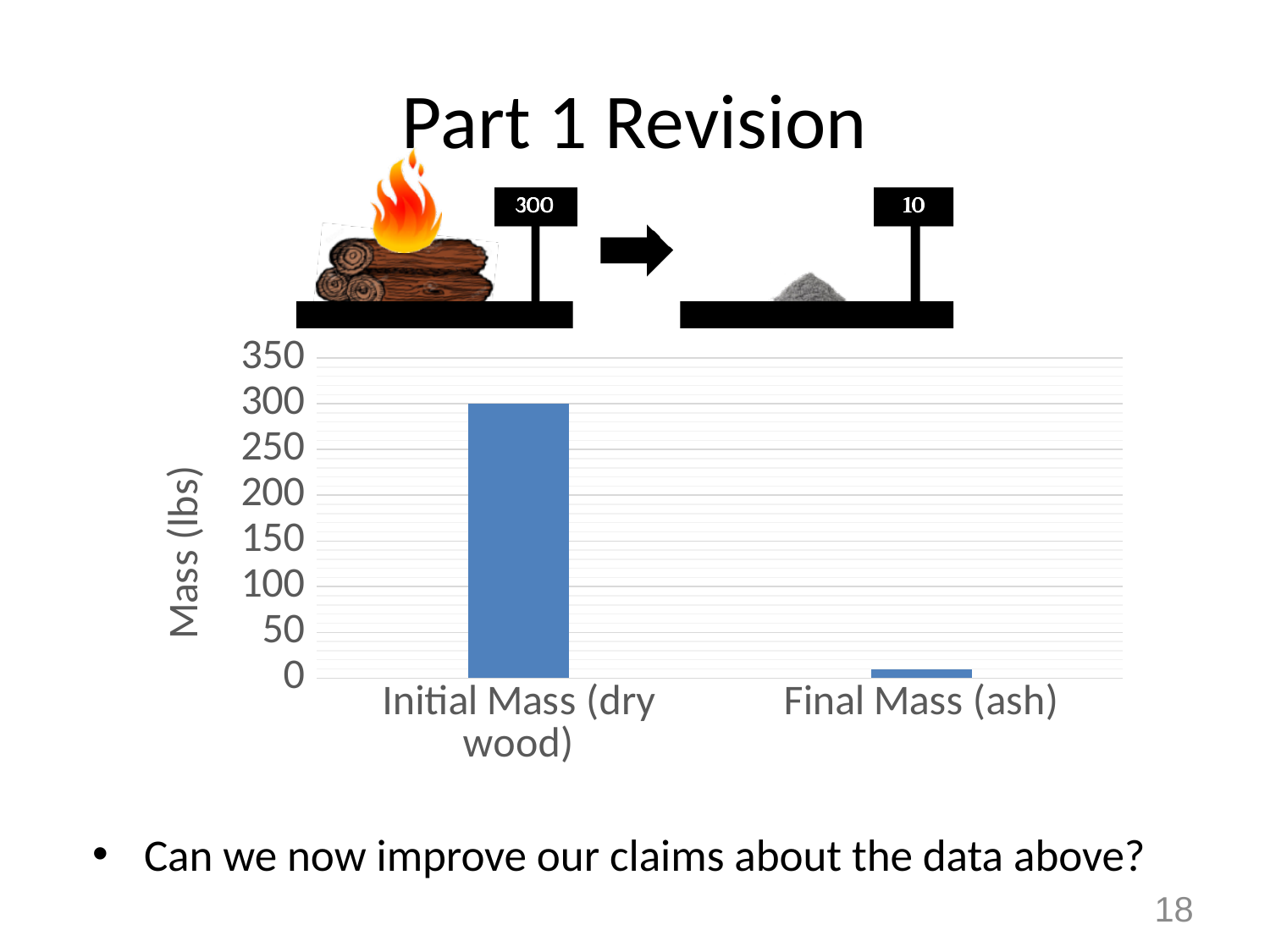
Which category has the highest value in the chart? Initial Mass (dry wood) How many categories are plotted in the chart? 2 Is the value for Initial Mass (dry wood) greater or less than 250? greater What is the label on the vertical axis of the chart? Mass (lbs) What is the highest tick value shown on the vertical axis? 350 Which is larger, the value for Initial Mass (dry wood) or the value for Final Mass (ash)? Initial Mass (dry wood) What is the value for Initial Mass (dry wood) in the chart? 300 Which category has the lowest value in the chart? Final Mass (ash) Do the values rise or fall from left to right across the categories? fall Is the value for Final Mass (ash) greater or less than 50? less What type of chart is shown on the slide? bar chart